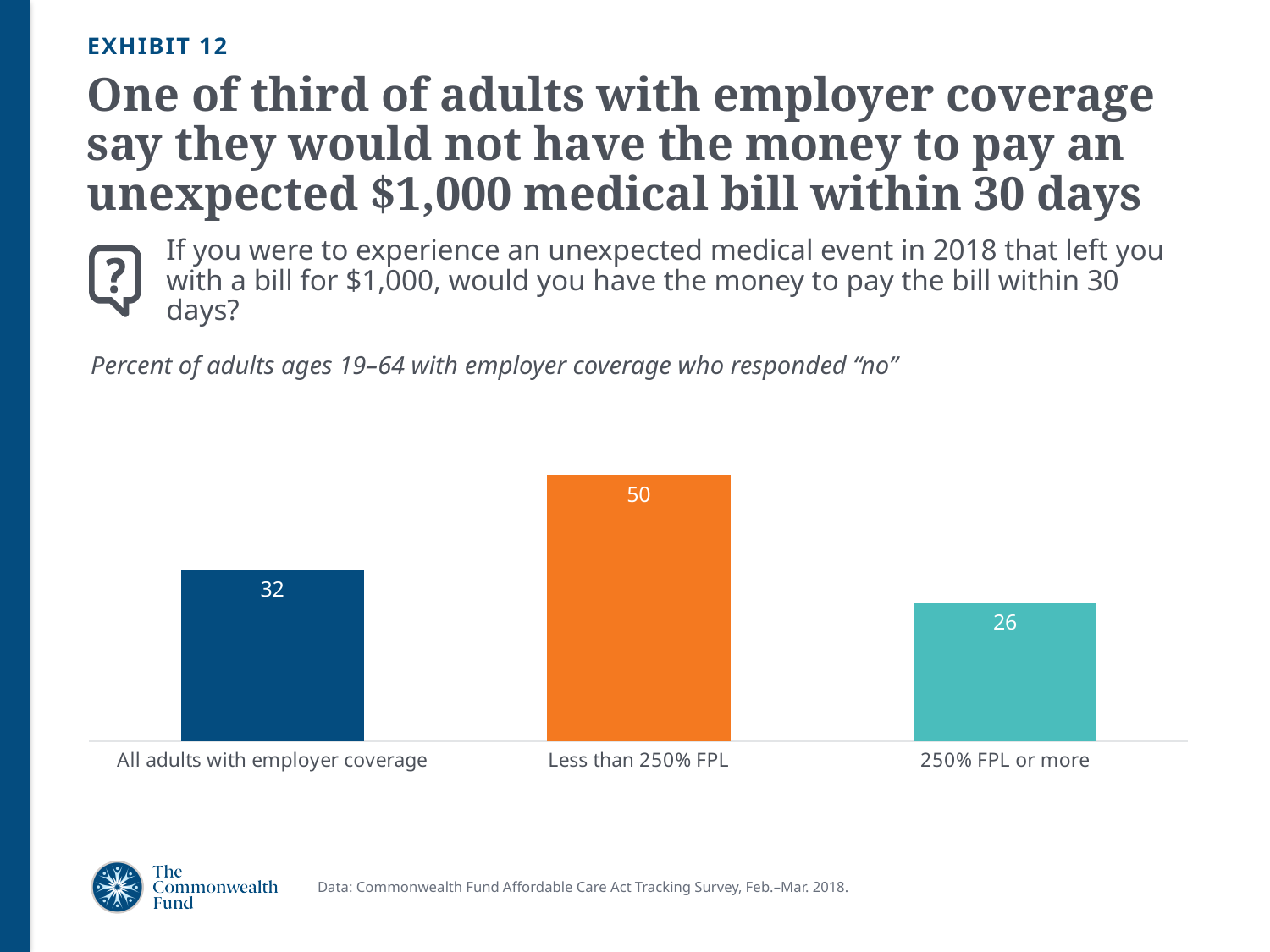
Which is larger, the value for All adults with employer coverage or the value for 250% FPL or more? All adults with employer coverage What is the difference between the values for Less than 250% FPL and 250% FPL or more? 24 Which category has the lowest value? 250% FPL or more What is the value for All adults with employer coverage? 32 Which category has the highest value? Less than 250% FPL What kind of chart is shown on the slide? Bar chart What colour is the bar for Less than 250% FPL? Orange How many categories are shown in the chart? 3 What does the chart measure, according to the subtitle above it? Percent of adults ages 19–64 with employer coverage who responded "no" What is the difference between the values for Less than 250% FPL and All adults with employer coverage? 18 What is the value for 250% FPL or more? 26 What is the value for Less than 250% FPL? 50